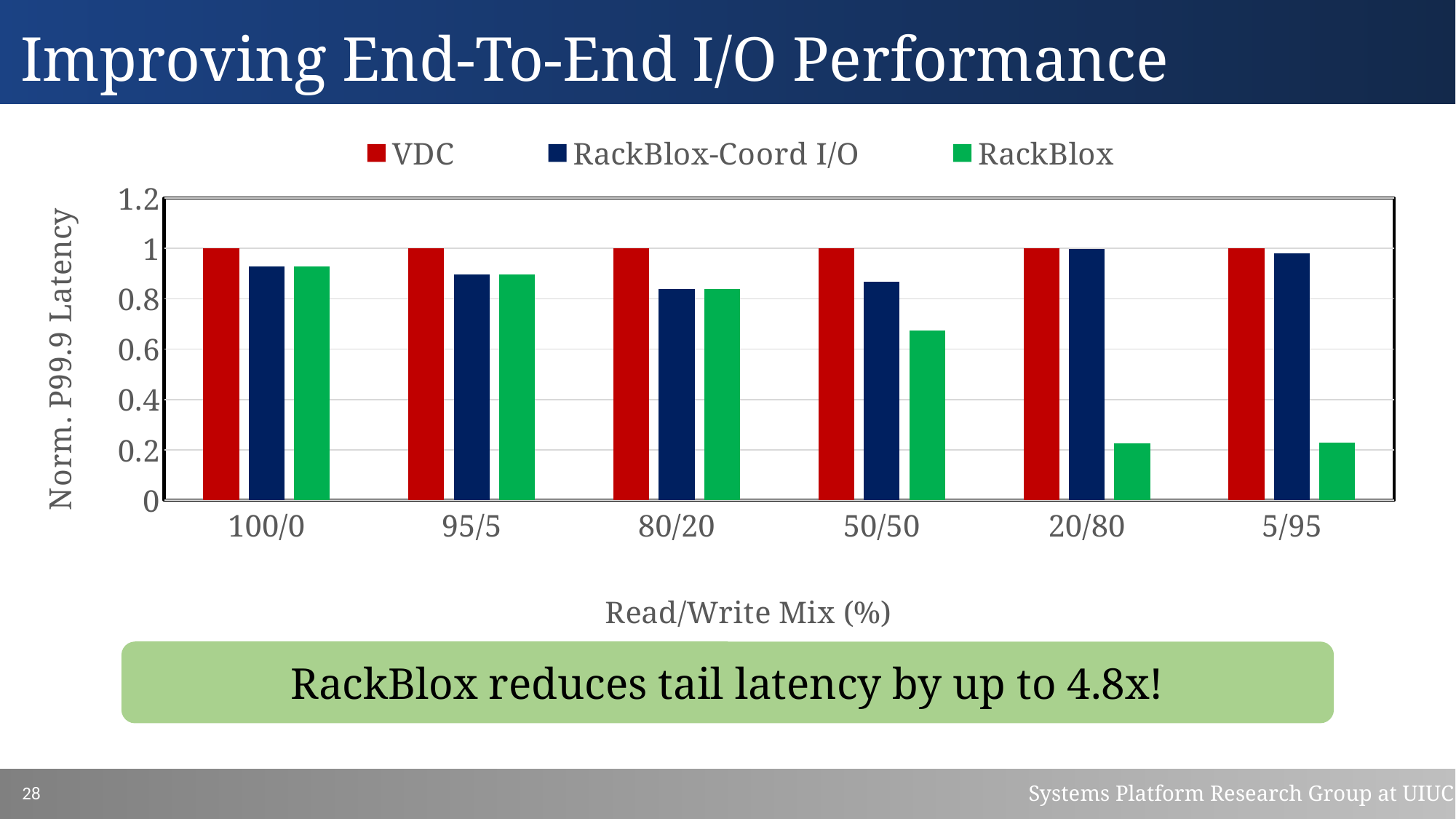
Is the value for RackBlox-Coord I/O at the 80/20 read/write mix greater or less than 0.8? greater What is the normalized P99.9 latency for VDC at the 50/50 read/write mix? 1 How many read/write mix categories are shown on the x axis? 6 What kind of chart is shown on the slide? bar chart At the 50/50 read/write mix, which is larger: RackBlox-Coord I/O or RackBlox? RackBlox-Coord I/O How many series does the legend list? 3 Is the value for RackBlox at the 20/80 read/write mix greater or less than 0.4? less Does the RackBlox series rise or fall as the read/write mix moves from 100/0 to 5/95? fall Is the value for RackBlox at the 50/50 read/write mix greater or less than 0.8? less What is the label of the y axis? Norm. P99.9 Latency Which series is shown in green in the legend? RackBlox Which series has the lowest value at the 5/95 read/write mix? RackBlox